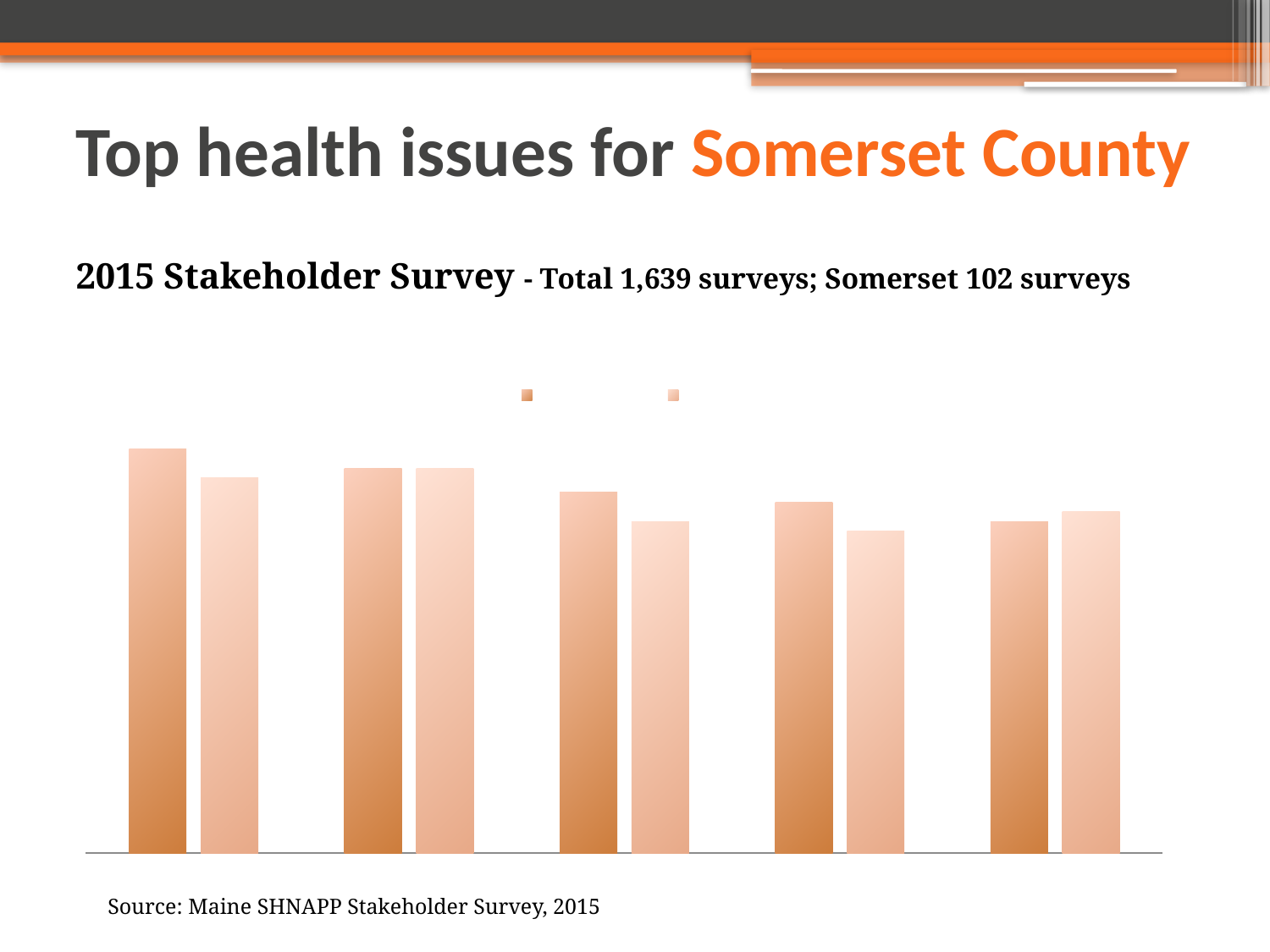
How many series does the chart's legend list? 2 In the leftmost group of bars, is the darker orange bar or the lighter orange bar taller? the darker orange bar How many groups of bars are plotted in the chart? 5 In the rightmost group of bars, is the darker orange bar or the lighter orange bar taller? the lighter orange bar Do the darker orange bars rise or fall from left to right across the chart? fall Which group of bars contains the tallest bar in the chart? the leftmost group What is the source cited below the chart? Maine SHNAPP Stakeholder Survey, 2015 What kind of chart is shown on the slide? bar chart